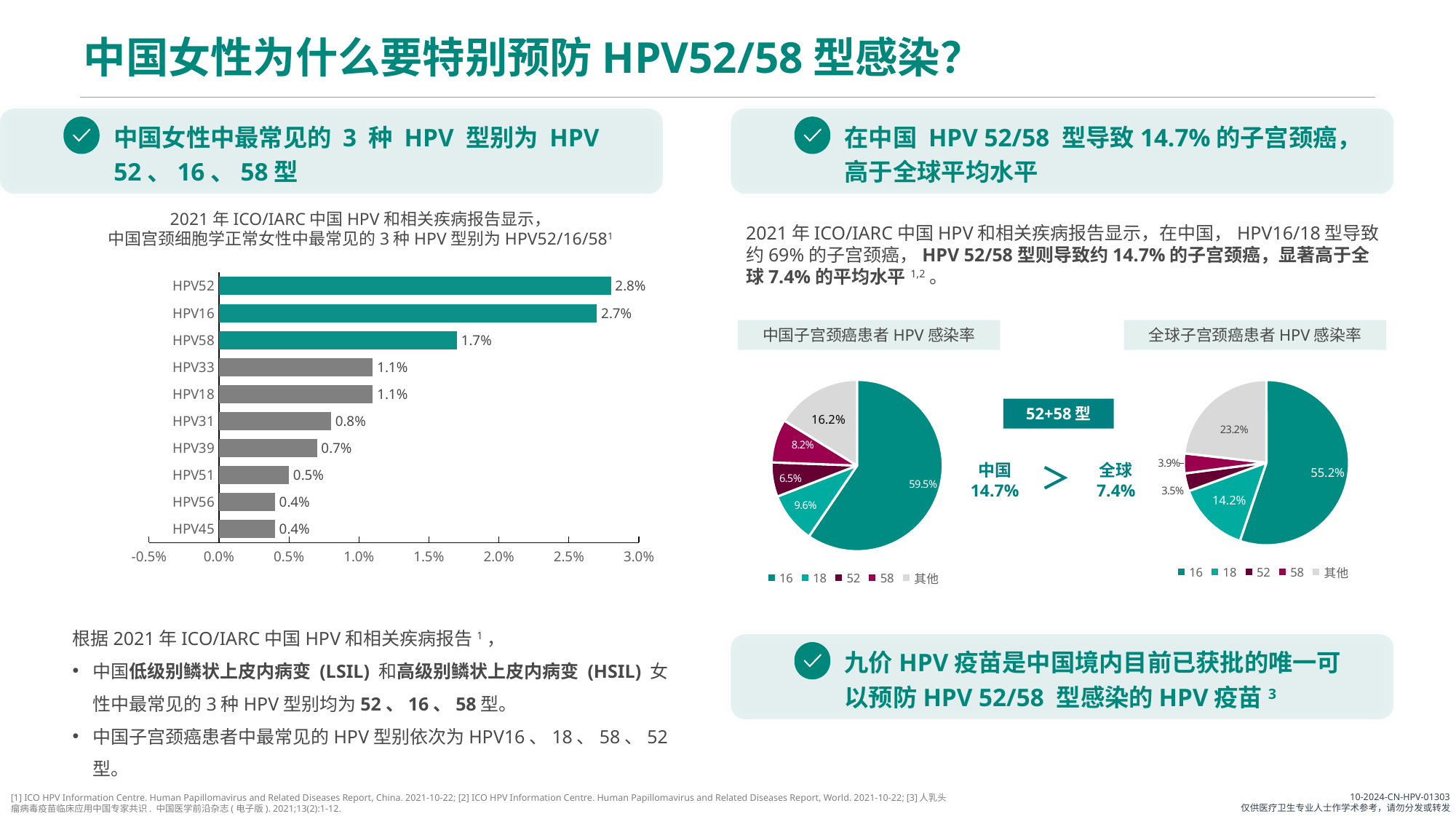
In the left bar chart, what is the value for HPV52? 2.8% In the pie chart titled 全球子宫颈癌患者 HPV 感染率, what is the combined share of types 52 and 58? 7.4% In the pie chart titled 中国子宫颈癌患者 HPV 感染率, what is the value for type 58? 8.2% In the pie chart titled 中国子宫颈癌患者 HPV 感染率, what share does type 16 have? 59.5% In the left bar chart, what is the difference between the values for HPV52 and HPV58? 1.1% In the left bar chart, what is the value for HPV58? 1.7% How many HPV types are shown in the left bar chart? 10 What kind of chart is the chart on the left of the slide? Bar chart In the pie chart titled 全球子宫颈癌患者 HPV 感染率, what is the value for type 18? 14.2% How many entries does the legend of the pie chart titled 中国子宫颈癌患者 HPV 感染率 list? 5 In the left bar chart, which is larger, the value for HPV33 or the value for HPV31? HPV33 In the left bar chart, which HPV type has the highest value? HPV52